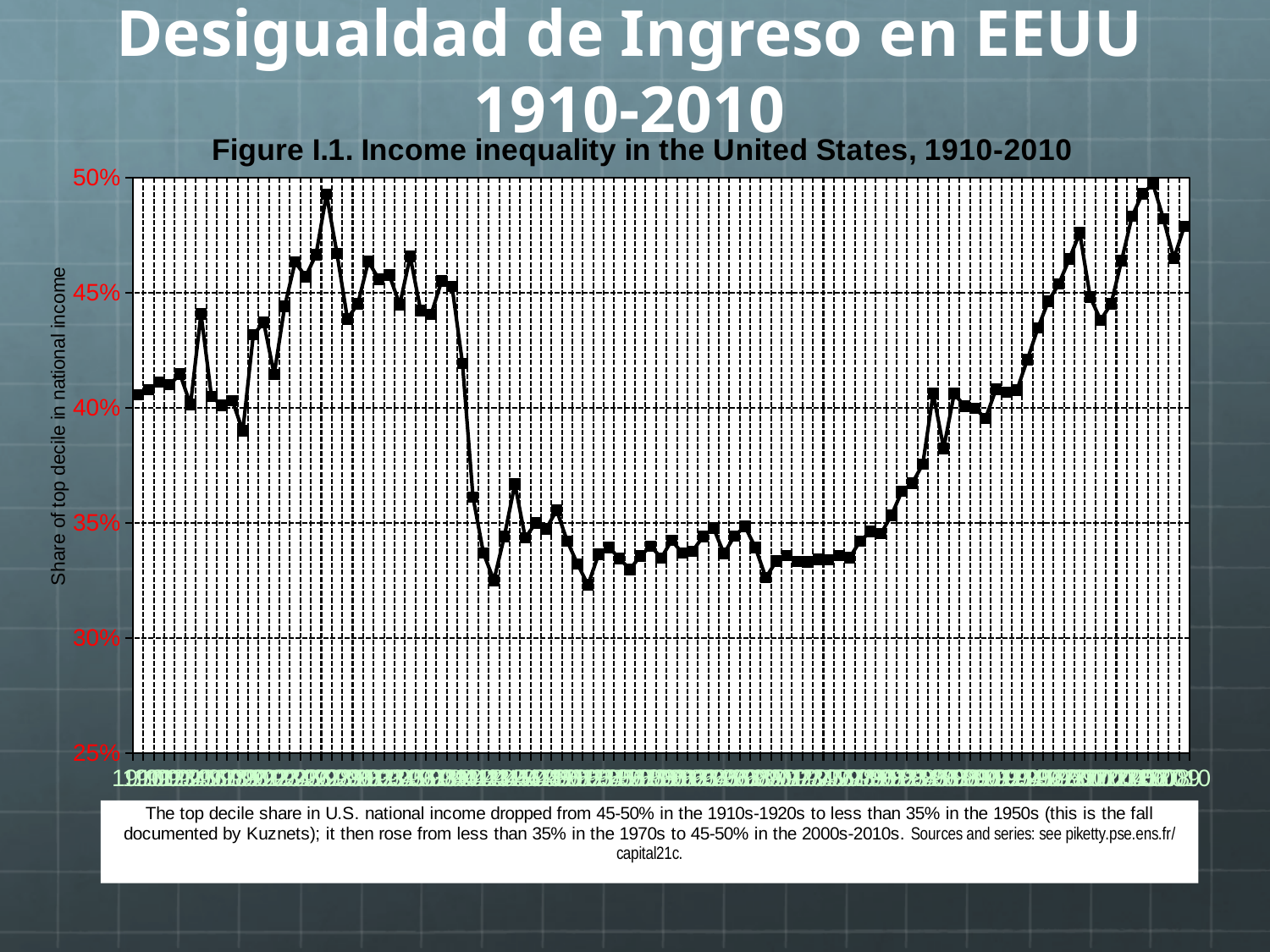
Over the right-hand third of the chart, do the values generally rise or fall? rise Is the lowest point on the line greater or less than 30%? greater What is the title of the chart? Figure I.1. Income inequality in the United States, 1910-2010 What kind of chart is shown on the slide? line chart Are the values in the middle section of the chart (the long flat stretch) mostly above or below 35%? below What is the lowest value shown on the vertical axis? 25% How many data series are plotted on the chart? 1 Is the last (rightmost) point on the line greater or less than 45%? greater Is the rightmost point on the line higher or lower than the leftmost point? higher What is the label on the vertical axis of the chart? Share of top decile in national income What is the highest value shown on the vertical axis? 50%